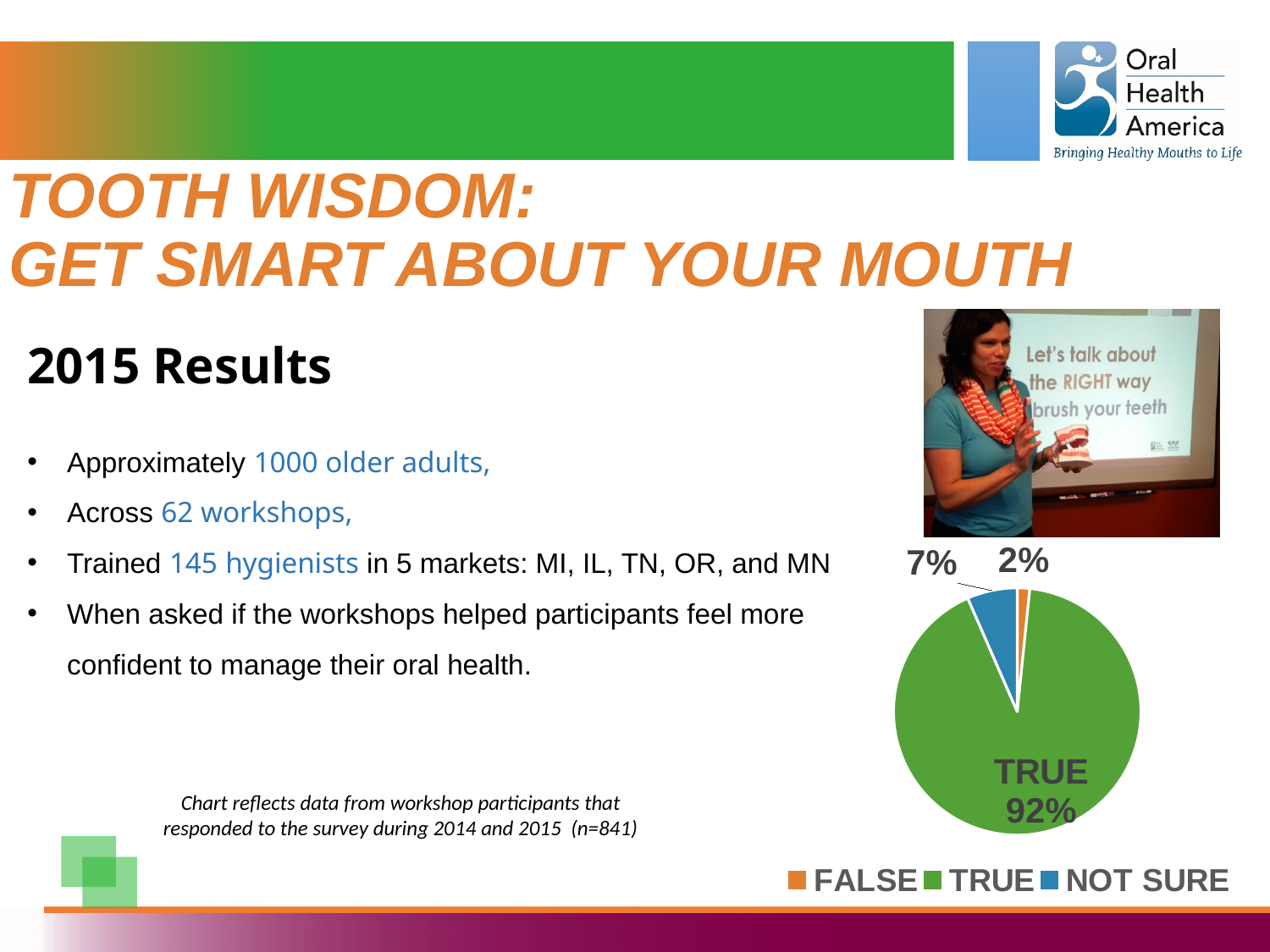
What percentage does the NOT SURE slice of the pie chart represent? 7% What percentage of the pie chart is labelled TRUE? 92% What is the difference in percentage points between the TRUE and NOT SURE slices? 85 Which legend entry is shown in orange in the pie chart? FALSE Which category has the largest slice in the pie chart? TRUE How many categories does the pie chart legend list? 3 What colour is the TRUE slice in the pie chart? green What is the combined percentage of the FALSE and NOT SURE slices? 9% Which is larger in the pie chart, NOT SURE or FALSE? NOT SURE What kind of chart is shown on the slide? pie chart Which category has the smallest slice in the pie chart? FALSE What percentage does the FALSE slice of the pie chart represent? 2%